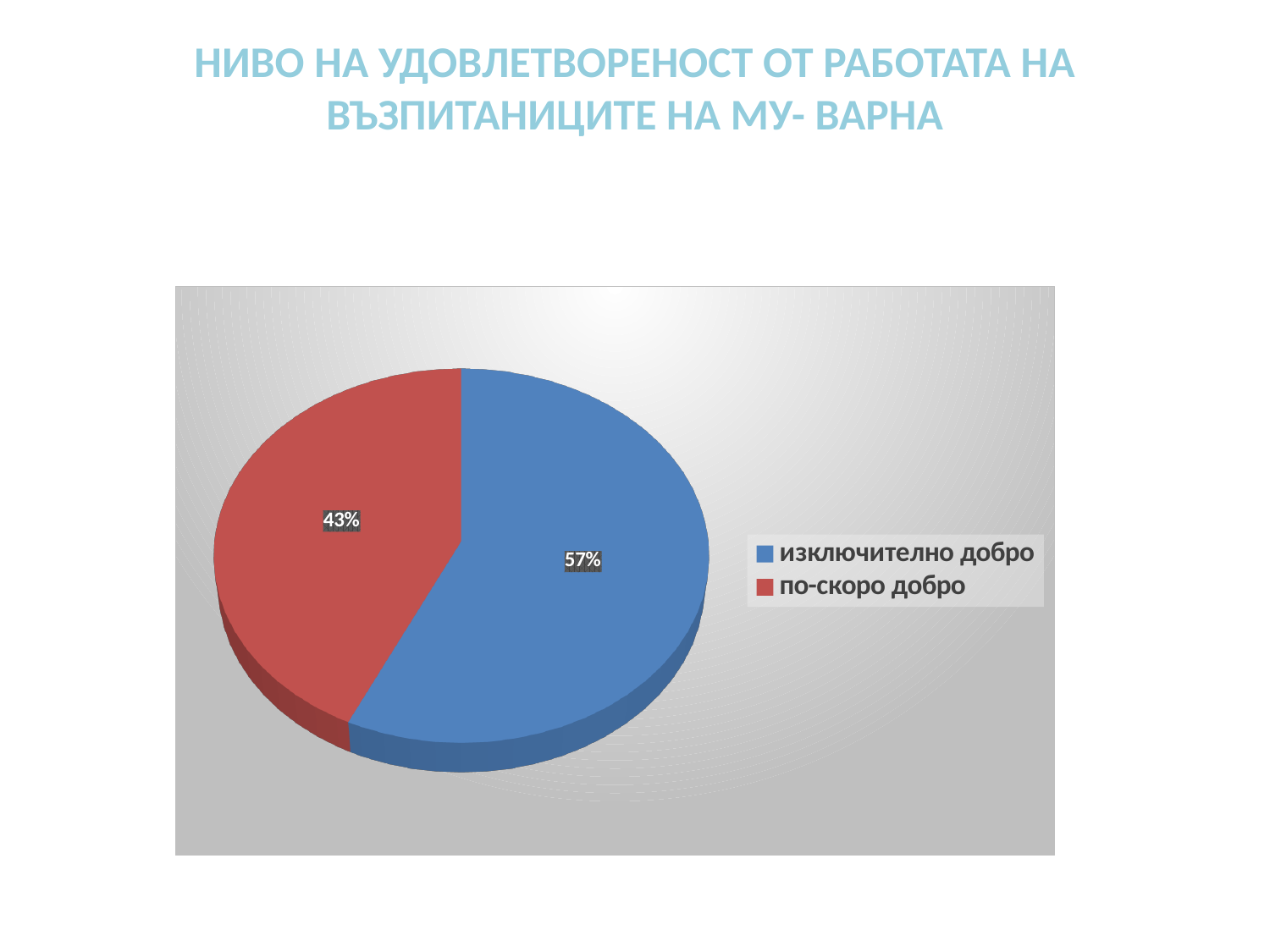
Which slice is the largest? изключително добро What kind of chart is shown on the slide? pie chart Which slice is the smallest? по-скоро добро What share of the pie does "изключително добро" have? 57% Which is larger, the share for "изключително добро" or for "по-скоро добро"? изключително добро How many entries does the legend list? 2 What colour is the slice for "по-скоро добро"? red What share of the pie does "по-скоро добро" have? 43% How many slices does the pie chart have? 2 What is the difference between the shares of "изключително добро" and "по-скоро добро"? 14% What colour is the slice for "изключително добро"? blue